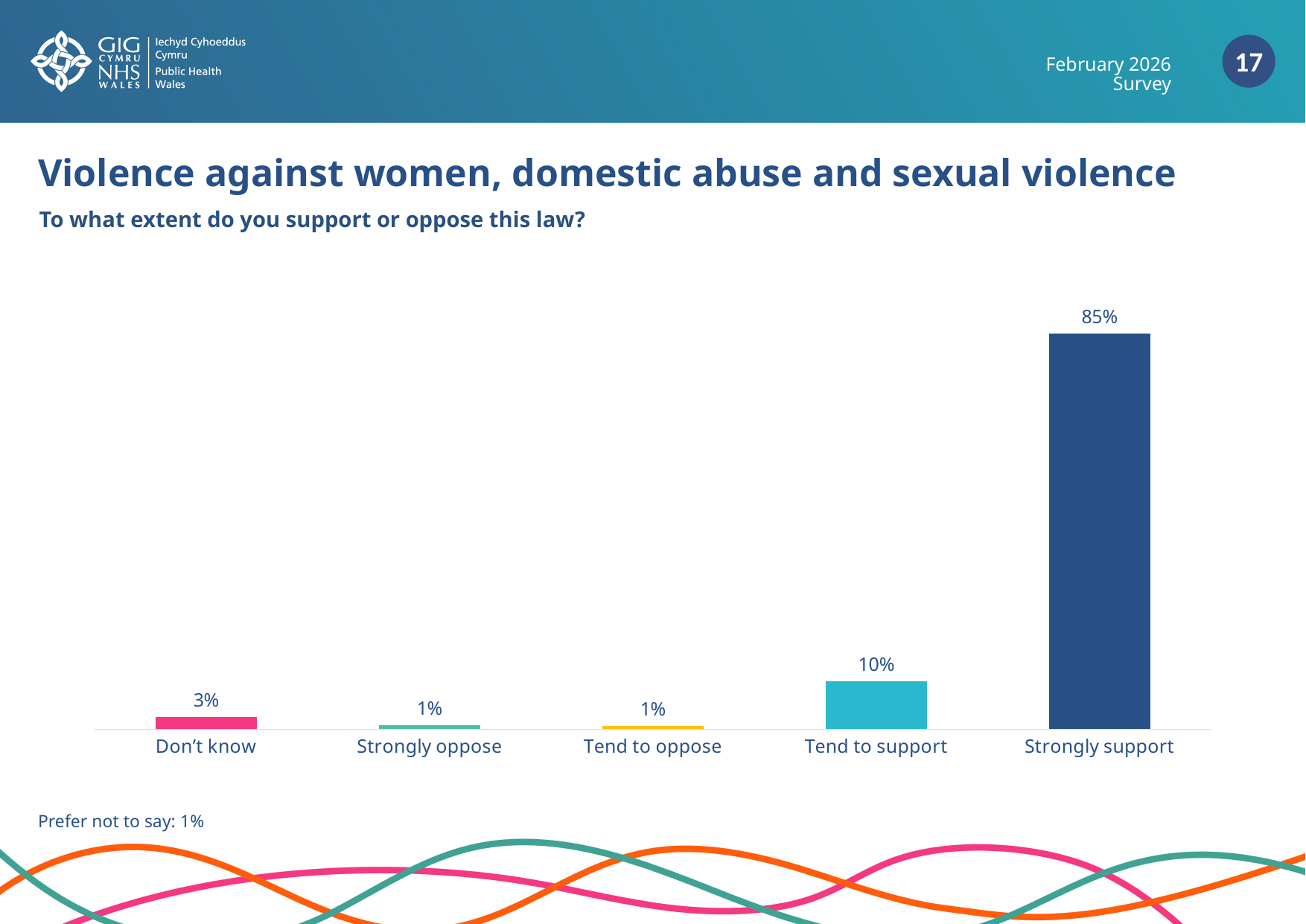
What kind of chart is shown on the slide? Bar chart What is the difference in percentage points between 'Don't know' and 'Tend to oppose'? 2 What percentage of respondents answered 'Don't know'? 3% What percentage of respondents said they strongly oppose this law? 1% Which response category has the highest percentage? Strongly support Which is larger, the value for 'Tend to support' or the value for 'Don't know'? Tend to support How many response categories are shown as bars in the chart? 5 What is the difference in percentage points between 'Strongly support' and 'Tend to support'? 75 What percentage is given for 'Prefer not to say' in the note below the chart? 1% What question is the chart answering, as stated in the subtitle? To what extent do you support or oppose this law? What percentage of respondents said they tend to support this law? 10% What percentage of respondents said they strongly support this law? 85%